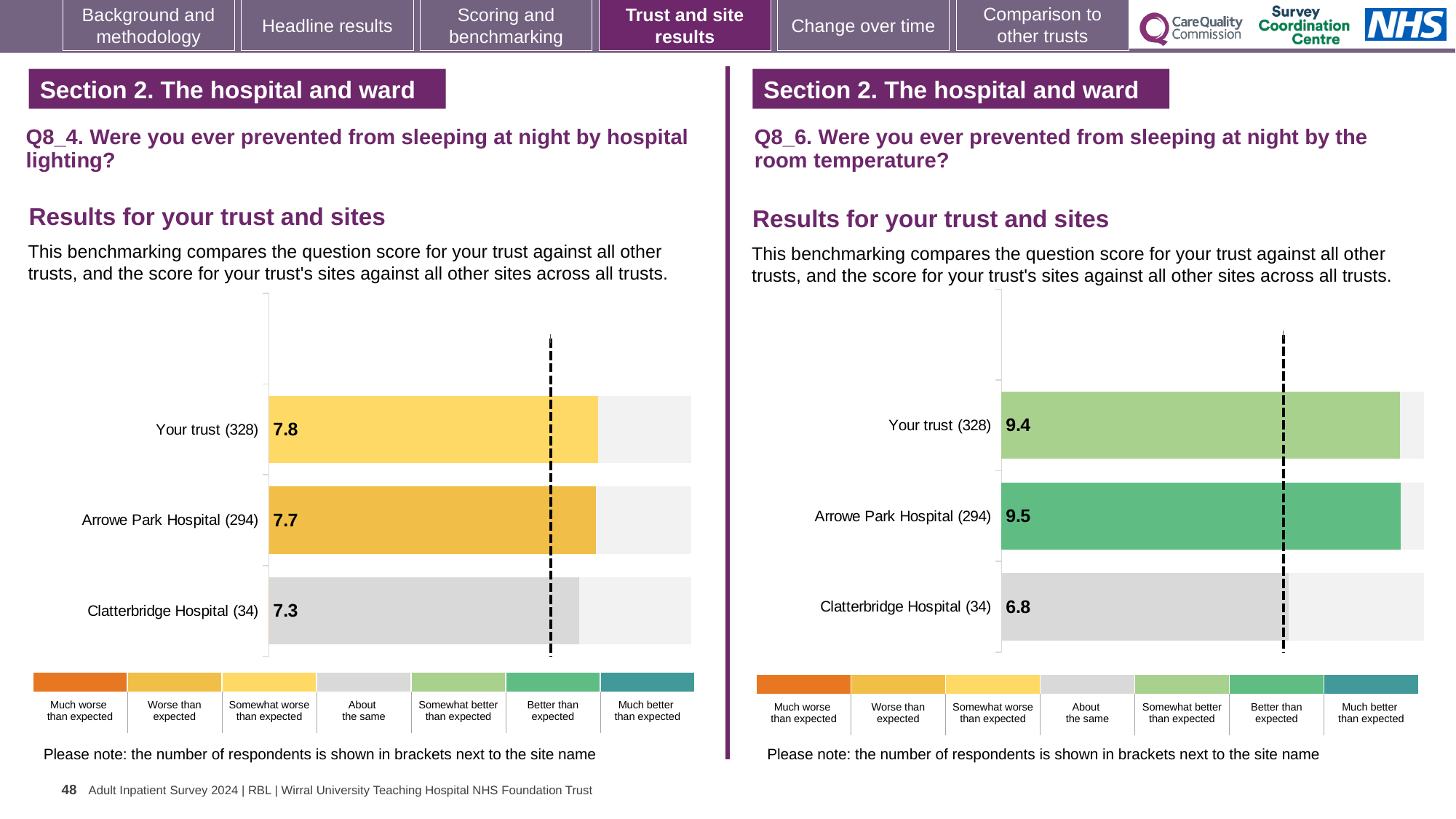
What kind of chart is used for the Q8_6 results (room temperature)? Bar chart In the Q8_4 chart (hospital lighting), what is the difference between the scores for Your trust (328) and Arrowe Park Hospital (294)? 0.1 In the Q8_6 chart (room temperature), what is the score for Arrowe Park Hospital (294)? 9.5 In the Q8_6 chart (room temperature), which site or trust has the highest score? Arrowe Park Hospital (294) In the Q8_4 chart (hospital lighting), which benchmark category does the colour of the Arrowe Park Hospital (294) bar correspond to? Worse than expected How many sites or trusts are plotted in the Q8_4 chart (hospital lighting)? 3 In the Q8_4 chart (hospital lighting), what is the score for Clatterbridge Hospital (34)? 7.3 In the Q8_4 chart (hospital lighting), which site or trust has the lowest score? Clatterbridge Hospital (34) In the Q8_6 chart (room temperature), what is the score for Clatterbridge Hospital (34)? 6.8 In the Q8_4 chart (hospital lighting), what is the score for Your trust (328)? 7.8 In the Q8_6 chart (room temperature), which has a larger score: Your trust (328) or Clatterbridge Hospital (34)? Your trust (328) In the Q8_6 chart (room temperature), what is the difference between the scores for Your trust (328) and Clatterbridge Hospital (34)? 2.6